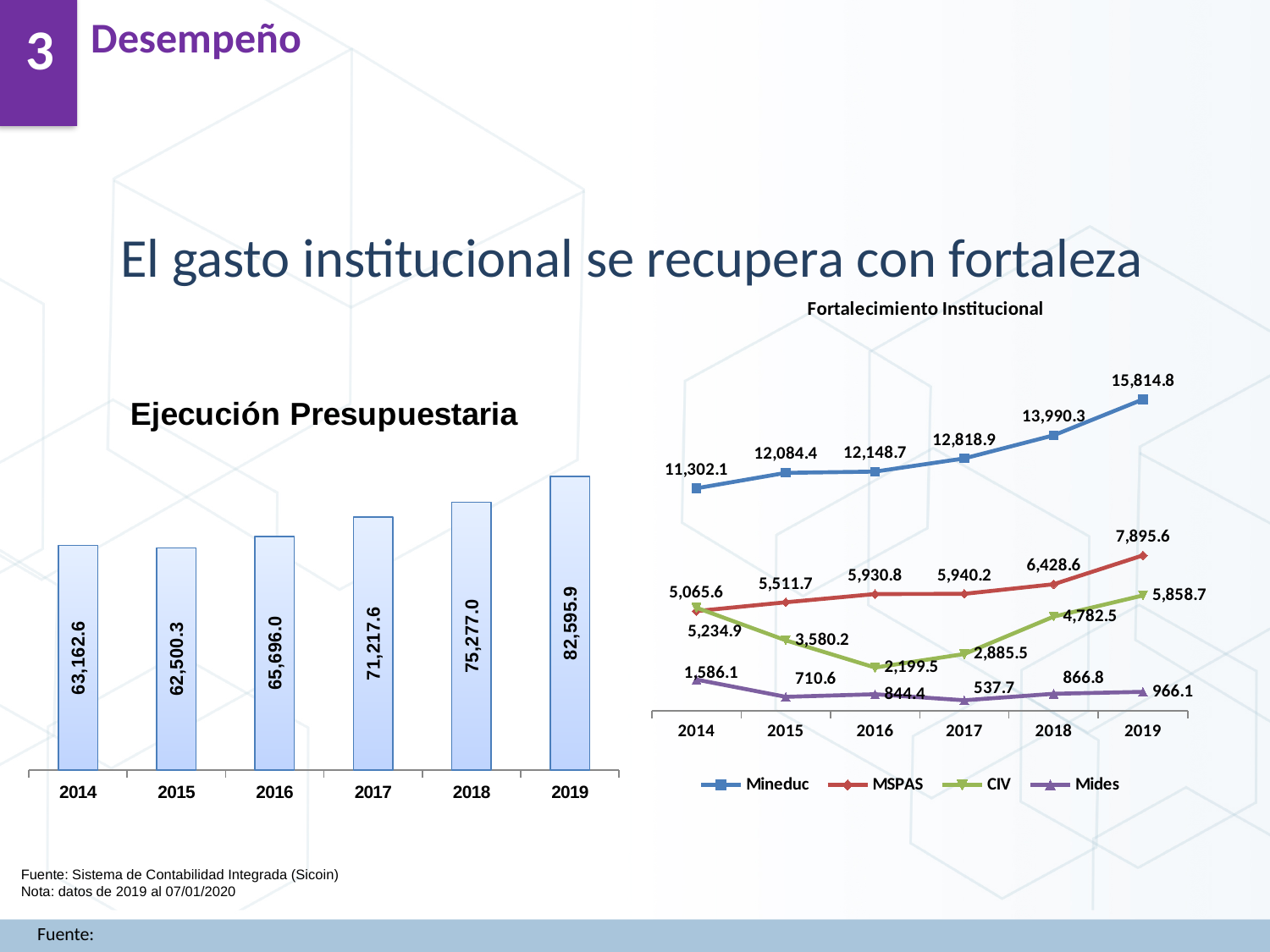
How many series does the legend of the Fortalecimiento Institucional chart list? 4 In the Ejecución Presupuestaria chart, what is the value for 2019? 82,595.9 How many years are shown in the Ejecución Presupuestaria chart? 6 In the Fortalecimiento Institucional chart, what is the value for Mineduc in 2017? 12,818.9 What kind of chart is the Ejecución Presupuestaria chart? Bar chart In the Fortalecimiento Institucional chart, does the Mineduc series rise or fall from 2014 to 2019? Rise In the Ejecución Presupuestaria chart, what is the difference between the 2019 and 2018 values? 7,318.9 In the Fortalecimiento Institucional chart, which series has the highest value in 2019? Mineduc In the Fortalecimiento Institucional chart, what is the value for CIV in 2016? 2,199.5 In the Fortalecimiento Institucional chart, which is larger in 2014: MSPAS or CIV? CIV In the Ejecución Presupuestaria chart, which year has the lowest value? 2015 In the Fortalecimiento Institucional chart, what is the difference between the Mides values for 2019 and 2018? 99.3